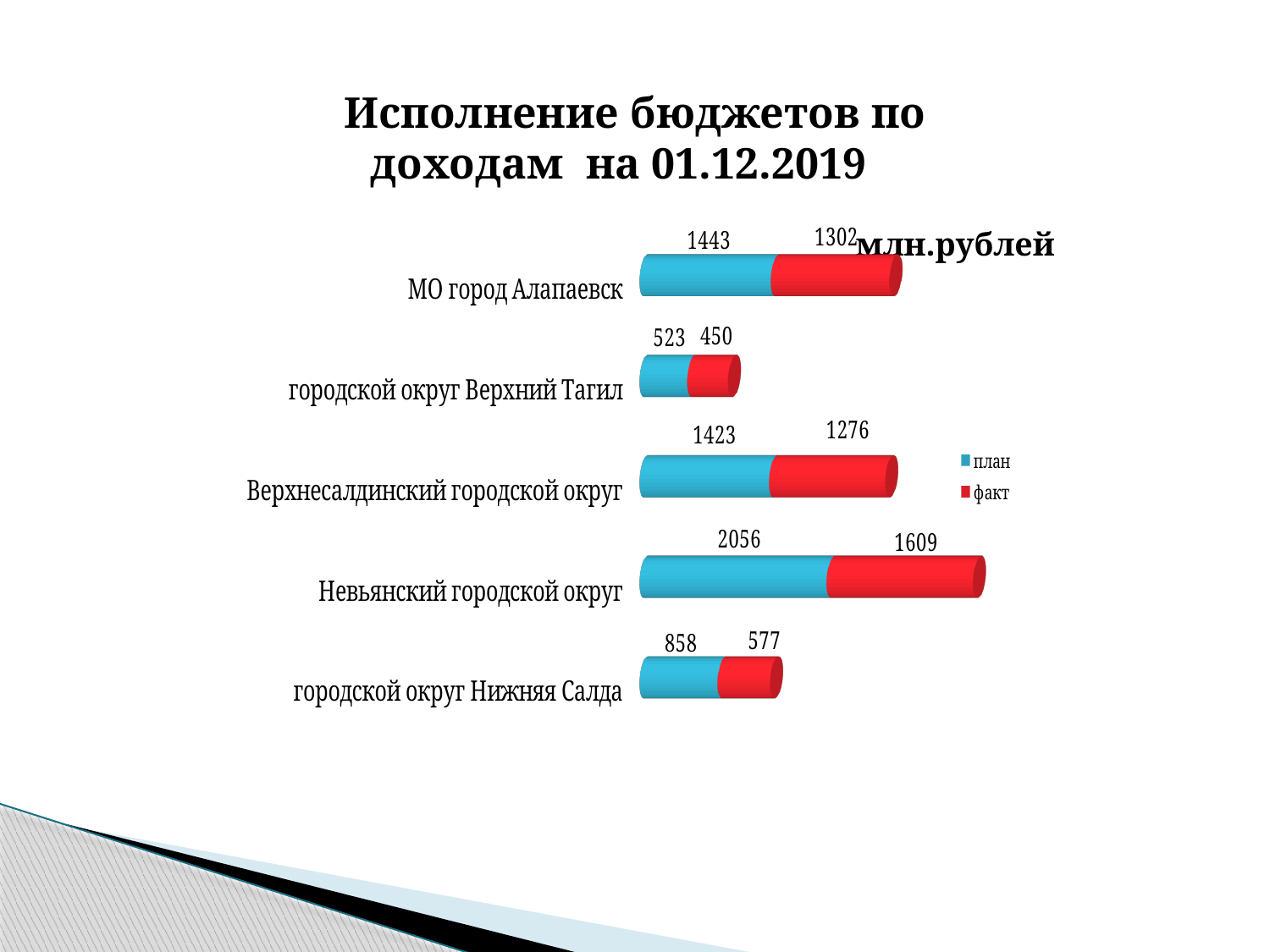
What is the difference between план and факт for Невьянский городской округ? 447 Which category has the highest план value? Невьянский городской округ What is the difference between план and факт for городской округ Нижняя Салда? 281 Which category has the lowest факт value? городской округ Верхний Тагил What is the план value for Невьянский городской округ? 2056 What is the total of the stacked bar for городской округ Верхний Тагил? 973 How many series does the legend list? 2 How many categories are shown in the chart? 5 What kind of chart is shown on the slide? bar chart What is the факт value for городской округ Верхний Тагил? 450 What is the факт value for МО город Алапаевск? 1302 Which is larger: the факт value for Верхнесалдинский городской округ or the факт value for МО город Алапаевск? МО город Алапаевск